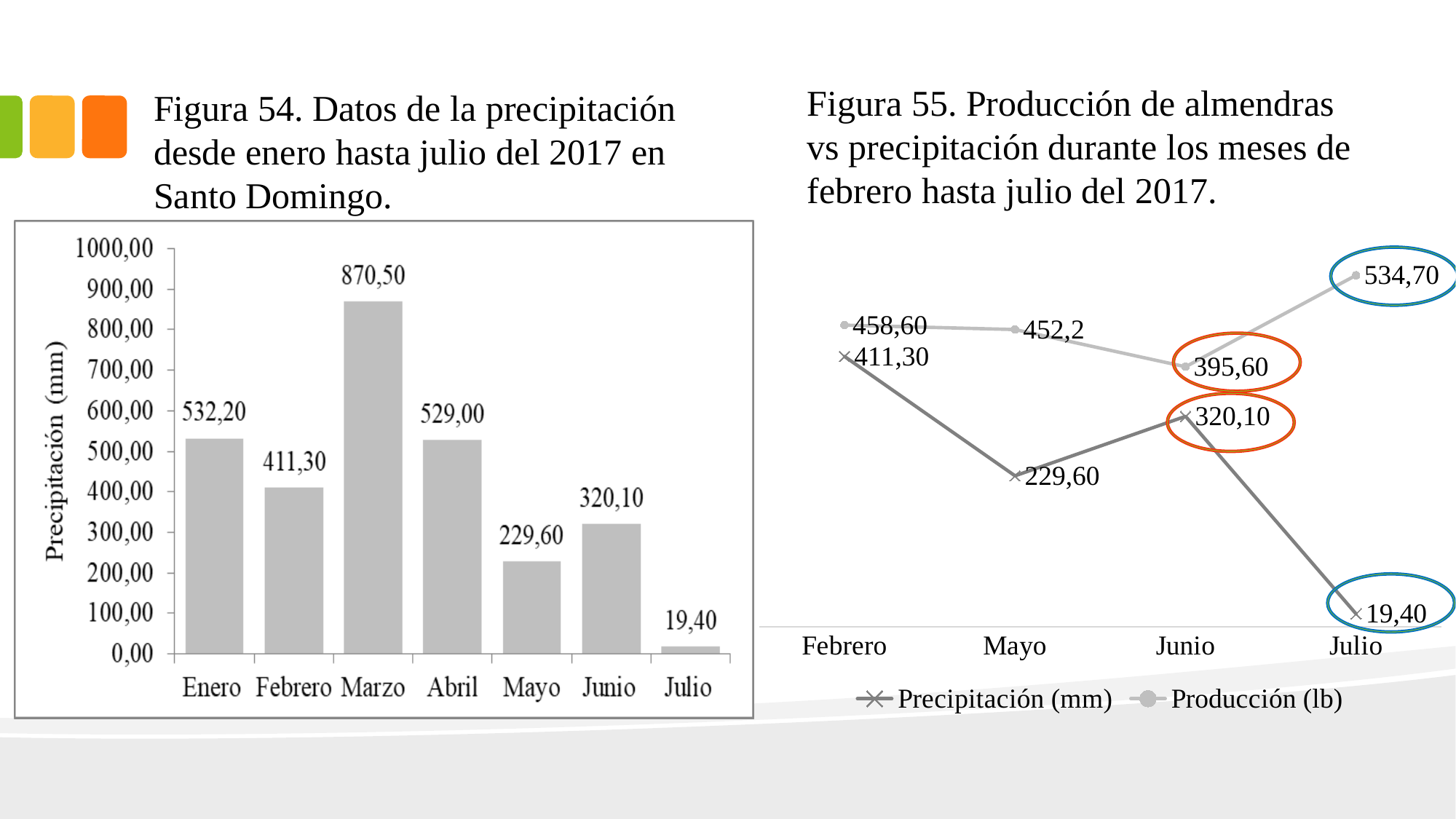
In the Figura 54 chart on the left, which month has the highest precipitation? Marzo In the Figura 54 chart on the left, how many months are shown on the x axis? 7 In the Figura 55 chart on the right, how many series does the legend list? 2 In the Figura 55 chart on the right, does the Precipitación (mm) series rise or fall from Junio to Julio? Fall In the Figura 54 chart on the left, which month has the lowest precipitation? Julio In the Figura 55 chart on the right, what is the difference between Producción (lb) in Julio and Junio? 139,10 In the Figura 54 chart on the left, what is the difference between the precipitation for Enero and Abril? 3,20 In the Figura 54 chart on the left, what kind of chart is it? Bar chart In the Figura 54 chart on the left, what is the precipitation value for Marzo? 870,50 In the Figura 54 chart on the left, is the precipitation for Mayo greater or less than Junio? Less In the Figura 55 chart on the right, what is the Producción (lb) value for Julio? 534,70 In the Figura 55 chart on the right, what is the Precipitación (mm) value for Junio? 320,10